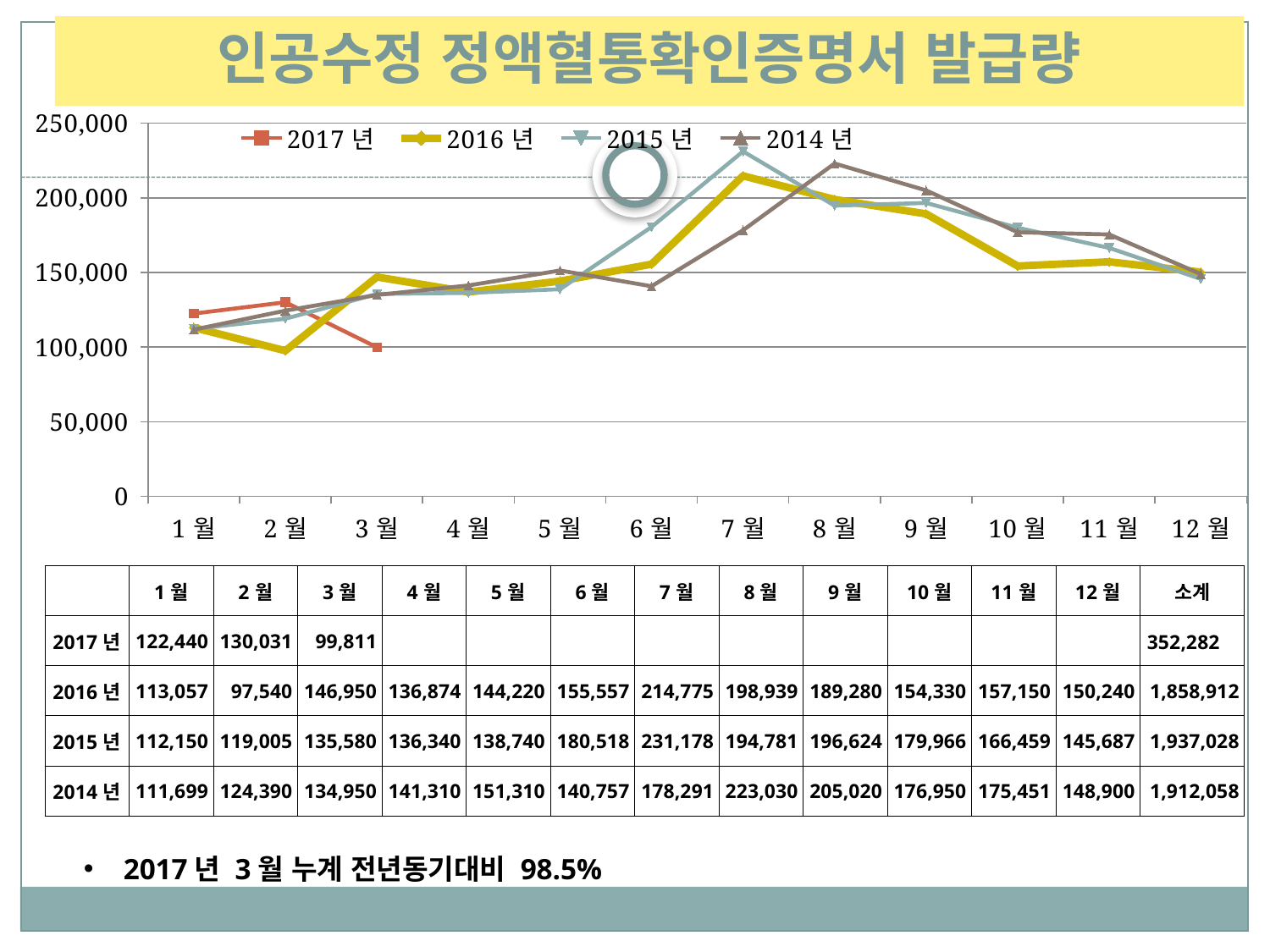
What is the value for 2014 년 in 8 월? 223,030 Which is larger in 8 월, the value for 2014 년 or for 2016 년? 2014 년 In which month does the 2016 년 series have its lowest value? 2 월 In which month does the 2015 년 series reach its highest value? 7 월 What is the value for 2016 년 in 7 월? 214,775 What is the difference between the 2015 년 and 2016 년 values in 7 월? 16,403 How many series does the legend list? 4 What is the value for 2017 년 in 3 월? 99,811 Does the 2017 년 series rise or fall from 2 월 to 3 월? fall What kind of chart is shown on the slide? line chart How many months are shown along the x axis? 12 Is the value for 2015 년 in 7 월 greater or less than 200,000? greater